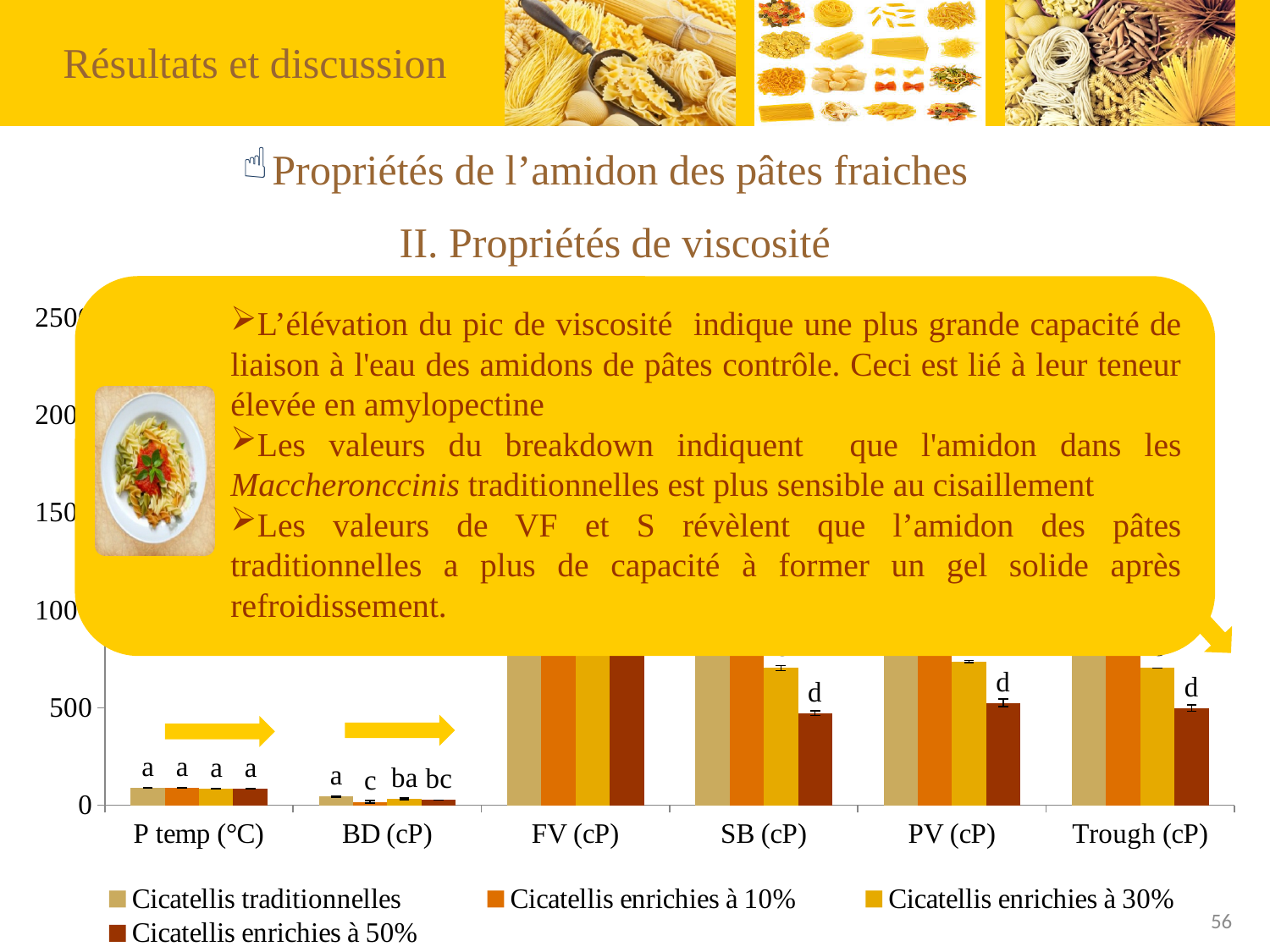
Which series is listed first in the chart legend? Cicatellis traditionnelles Is the value for PV (cP) for Cicatellis enrichies à 30% greater or less than 500? greater For Trough (cP), which is larger: the value for Cicatellis enrichies à 30% or for Cicatellis enrichies à 50%? Cicatellis enrichies à 30% Is the value for BD (cP) for Cicatellis enrichies à 50% greater or less than 500? less Is the value for P temp (°C) for Cicatellis traditionnelles greater or less than 500? less How many series does the chart legend list? 4 Which category is shown last on the x axis of the chart? Trough (cP) What kind of chart is shown on the slide? bar chart How many categories are shown on the x axis of the chart? 6 For SB (cP), which is larger: the value for Cicatellis traditionnelles or for Cicatellis enrichies à 50%? Cicatellis traditionnelles